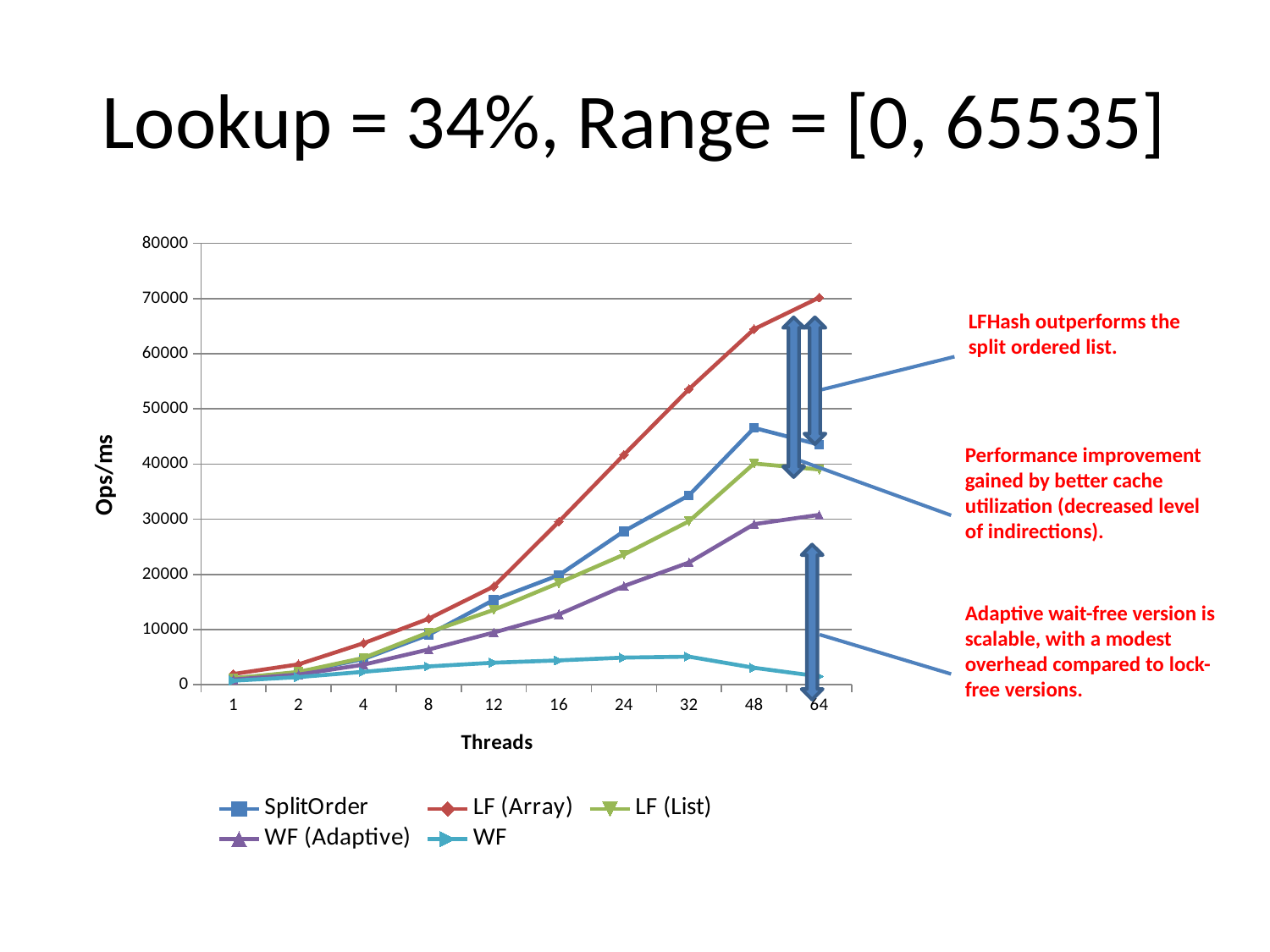
Is the value for WF at 32 threads greater or less than 10000? less Is the value for WF (Adaptive) at 64 threads greater or less than 20000? greater Which series has the lowest value at 64 threads? WF What kind of chart is shown on the slide? line chart At 48 threads, which is larger: SplitOrder or LF (List)? SplitOrder Which series has the highest value at 64 threads? LF (Array) Is the value for LF (Array) at 64 threads greater or less than 60000? greater Does the LF (Array) series rise or fall as the number of threads increases from 1 to 64? rises How many thread counts are plotted along the x axis? 10 What is the title of the y axis? Ops/ms How many series does the legend list? 5